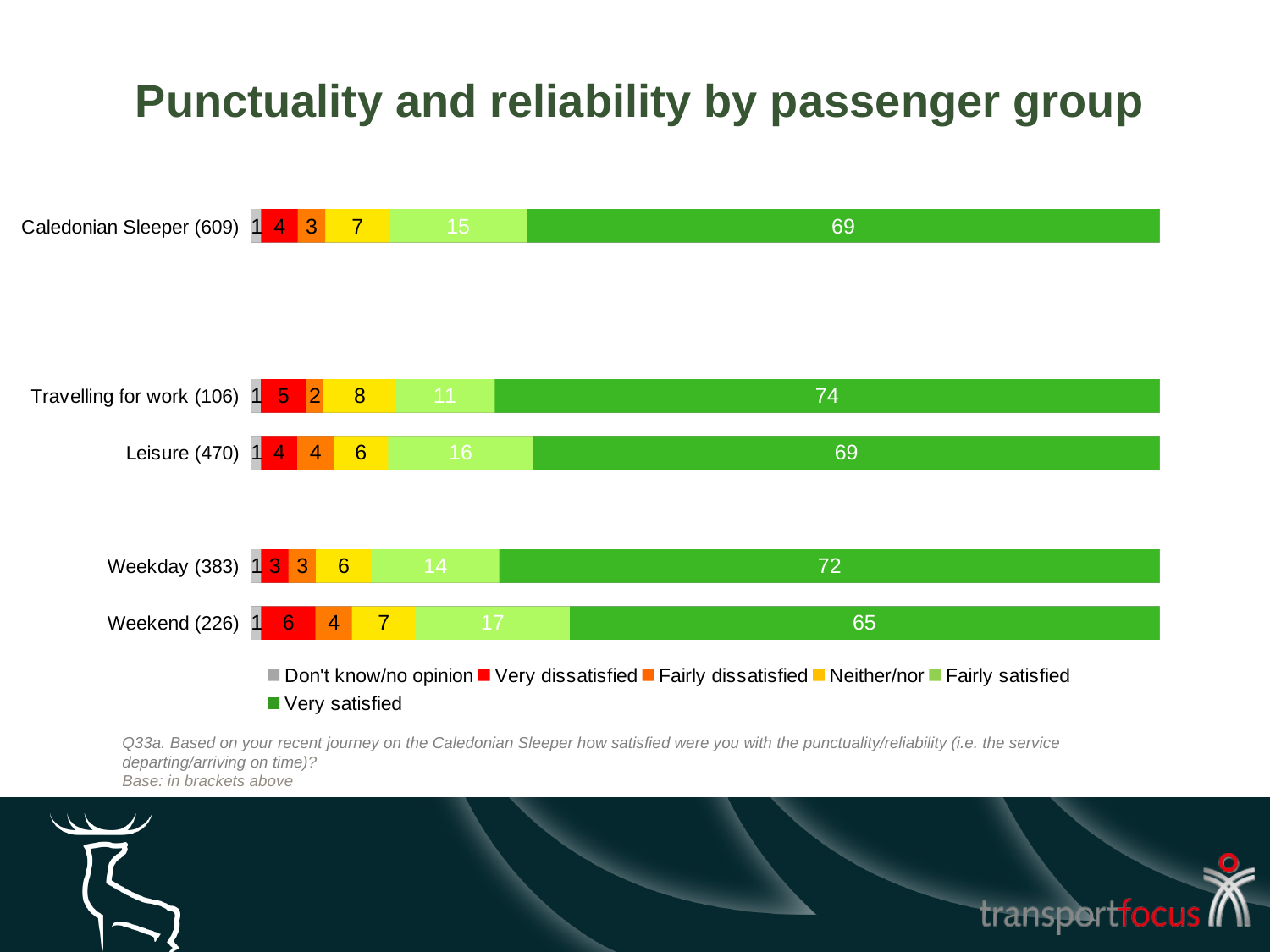
What is the Fairly satisfied value for Weekend (226)? 17 What is the Very dissatisfied value for Weekday (383)? 3 What is the total of the stacked bar for Weekend (226)? 100 How many passenger groups are shown in the chart? 5 Which passenger group has the highest Very satisfied value? Travelling for work (106) What is the difference between the Very satisfied values for Weekday (383) and Weekend (226)? 7 What kind of chart is shown on the slide? Stacked bar chart What is the Very satisfied value for Travelling for work (106)? 74 Which is larger, the Fairly satisfied value for Leisure (470) or for Travelling for work (106)? Leisure (470) What is the Neither/nor value for Leisure (470)? 6 Which passenger group has the lowest Very satisfied value? Weekend (226) How many series does the legend list? 6